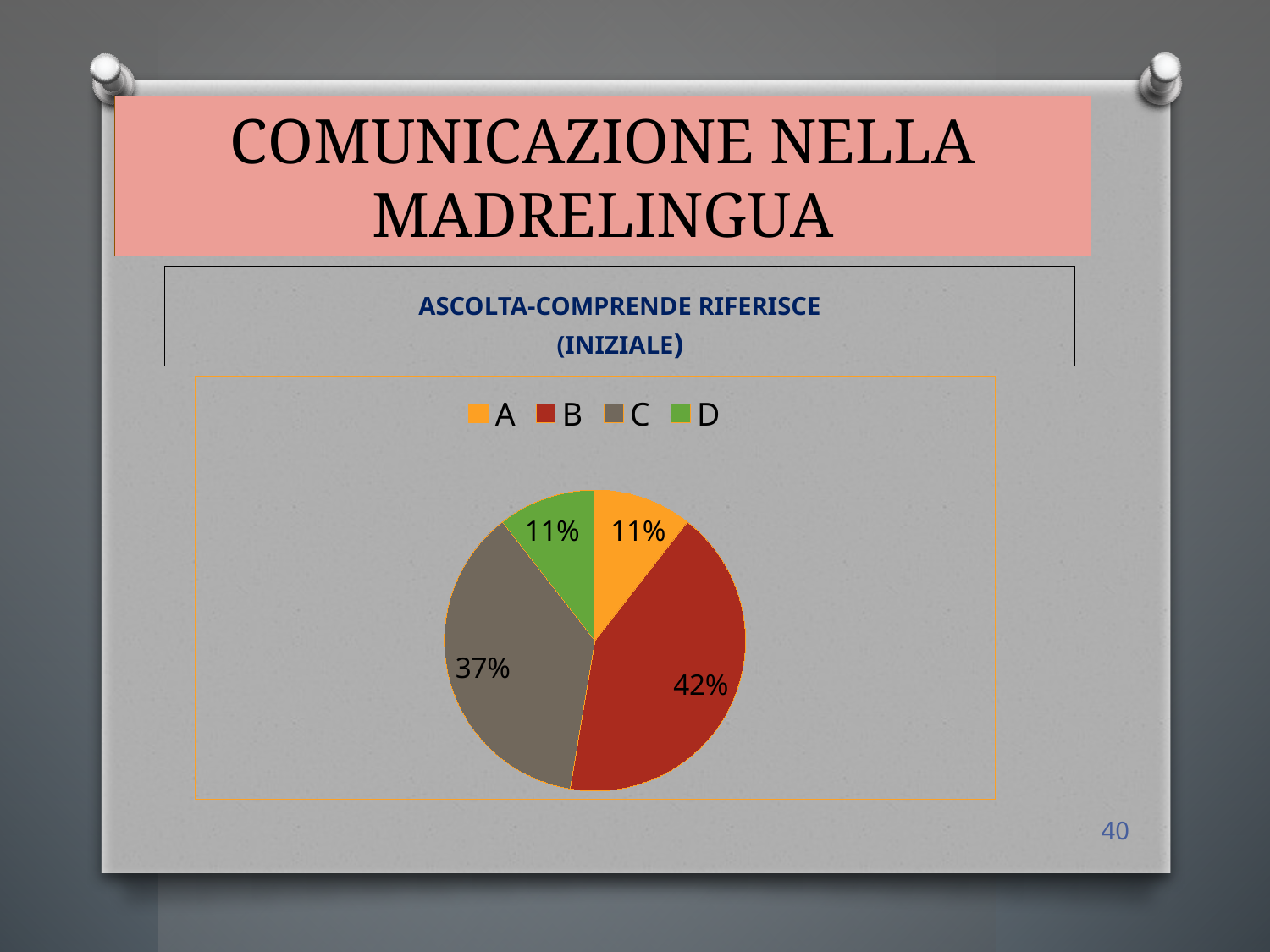
What colour is slice B in the pie chart? red What percentage of the pie does slice A represent? 11% Which slice is the largest in the pie chart? B How many slices does the pie chart have? 4 What is the difference in percentage points between slice C and slice A? 26 How many entries does the legend list? 4 What is the difference in percentage points between slice B and slice C? 5 What kind of chart is shown on the slide? pie chart What percentage of the pie does slice C represent? 37% What percentage of the pie does slice B represent? 42% What percentage of the pie does slice D represent? 11% Which slice is larger, B or C? B